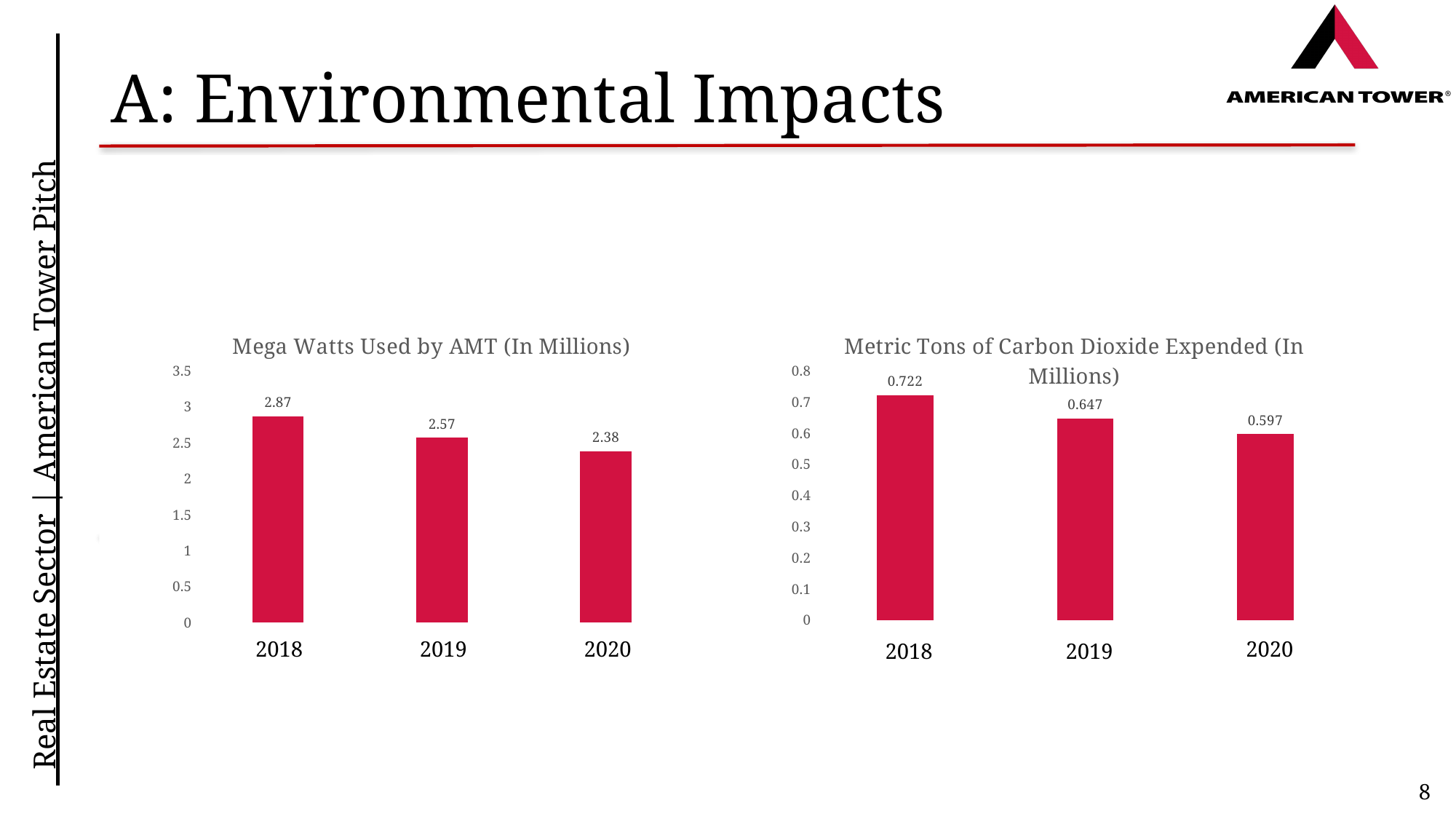
In the 'Metric Tons of Carbon Dioxide Expended (In Millions)' chart, what is the difference between the 2018 and 2019 values? 0.075 In the 'Metric Tons of Carbon Dioxide Expended (In Millions)' chart, what is the value for 2019? 0.647 In the 'Mega Watts Used by AMT (In Millions)' chart, what is the difference between the 2018 and 2020 values? 0.49 What kind of chart is the 'Metric Tons of Carbon Dioxide Expended (In Millions)' chart? bar chart In the 'Metric Tons of Carbon Dioxide Expended (In Millions)' chart, which year has the lowest value? 2020 In the 'Mega Watts Used by AMT (In Millions)' chart, what is the value for 2020? 2.38 In the 'Metric Tons of Carbon Dioxide Expended (In Millions)' chart, do the values rise or fall from 2018 to 2020? fall In the 'Mega Watts Used by AMT (In Millions)' chart, what is the value for 2018? 2.87 How many years are shown in the 'Mega Watts Used by AMT (In Millions)' chart? 3 In the 'Mega Watts Used by AMT (In Millions)' chart, which is larger, the value for 2019 or the value for 2020? 2019 In the 'Mega Watts Used by AMT (In Millions)' chart, which year has the highest value? 2018 In the 'Metric Tons of Carbon Dioxide Expended (In Millions)' chart, what is the value for 2020? 0.597